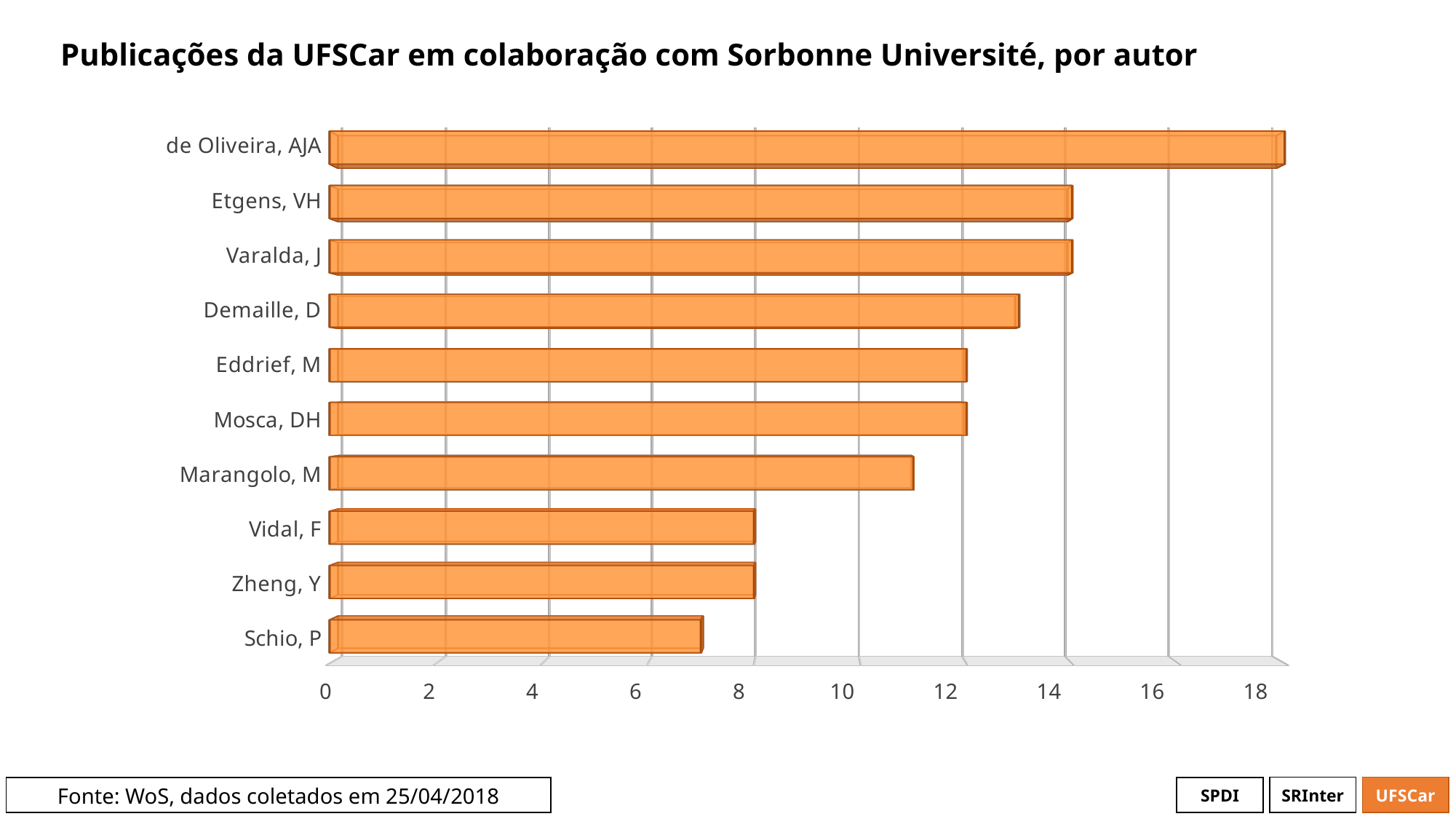
What kind of chart is shown on the slide? bar chart Is the value for Marangolo, M greater or less than 10? greater Is the value for Demaille, D greater or less than 14? less Who has more publications, Demaille, D or Marangolo, M? Demaille, D Who has more publications, Vidal, F or Schio, P? Vidal, F What is the title of the chart? Publicações da UFSCar em colaboração com Sorbonne Université, por autor Is the value for Schio, P greater or less than 8? less Which author has the highest number of publications? de Oliveira, AJA Which author has the lowest number of publications? Schio, P How many authors are shown in the chart? 10